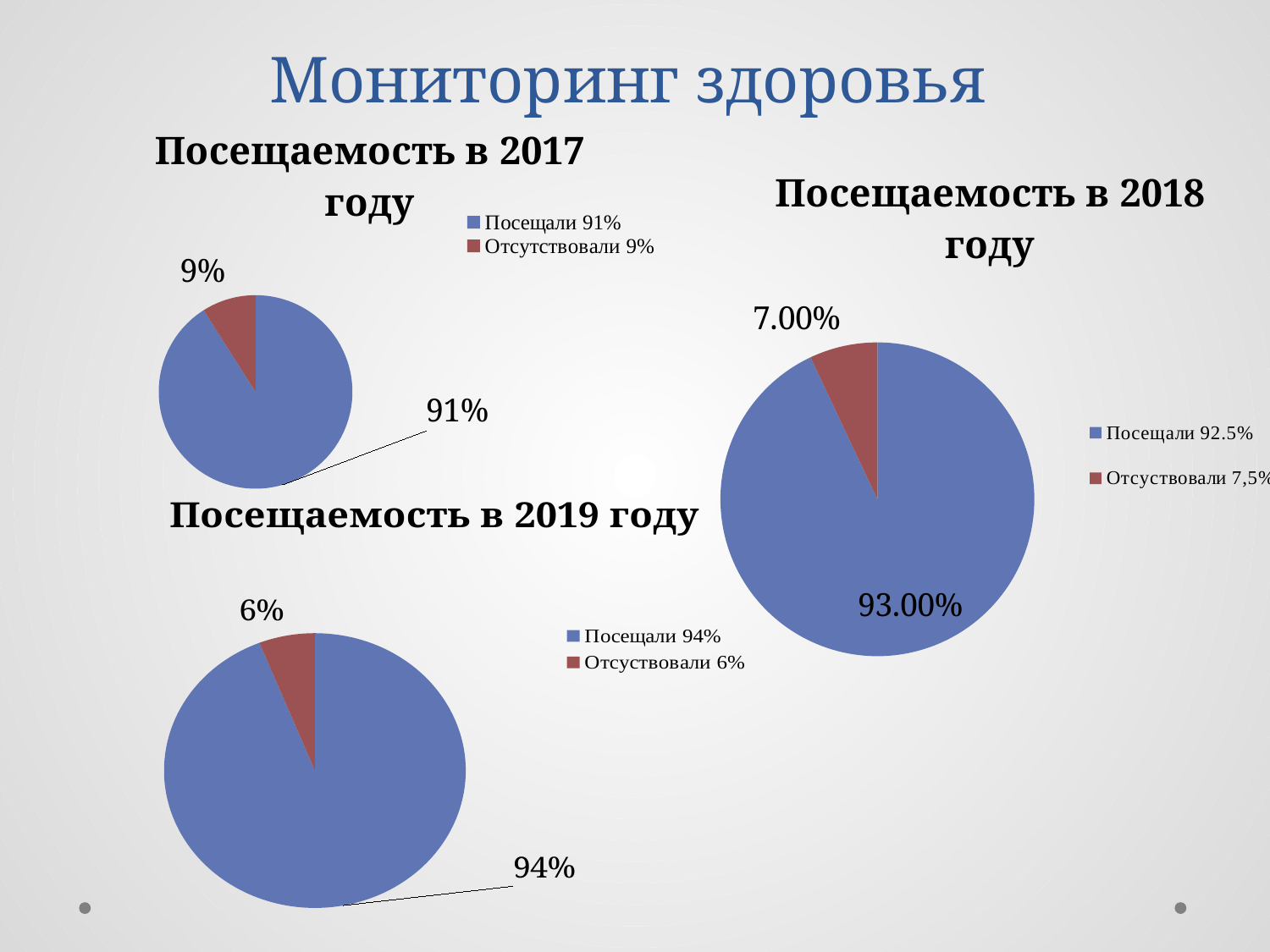
What kind of chart is "Посещаемость в 2017 году"? pie chart How many slices does the chart "Посещаемость в 2019 году" have? 2 In the chart "Посещаемость в 2017 году", which slice is the largest? Посещали In the chart "Посещаемость в 2019 году", what is the value for Посещали? 94% In the chart "Посещаемость в 2018 году", what data label is shown on the large blue slice? 93.00% In the chart "Посещаемость в 2018 году", what data label is shown on the small red slice? 7.00% In the chart "Посещаемость в 2017 году", what is the value for Отсутствовали? 9% In the chart "Посещаемость в 2017 году", what is the value for Посещали? 91% In the chart "Посещаемость в 2019 году", what is the value for Отсуствовали? 6% In the chart "Посещаемость в 2019 году", what is the difference between the Посещали and Отсуствовали slices? 88% In the chart "Посещаемость в 2018 году", which slice is the smallest? Отсуствовали How many entries does the legend of the chart "Посещаемость в 2017 году" list? 2